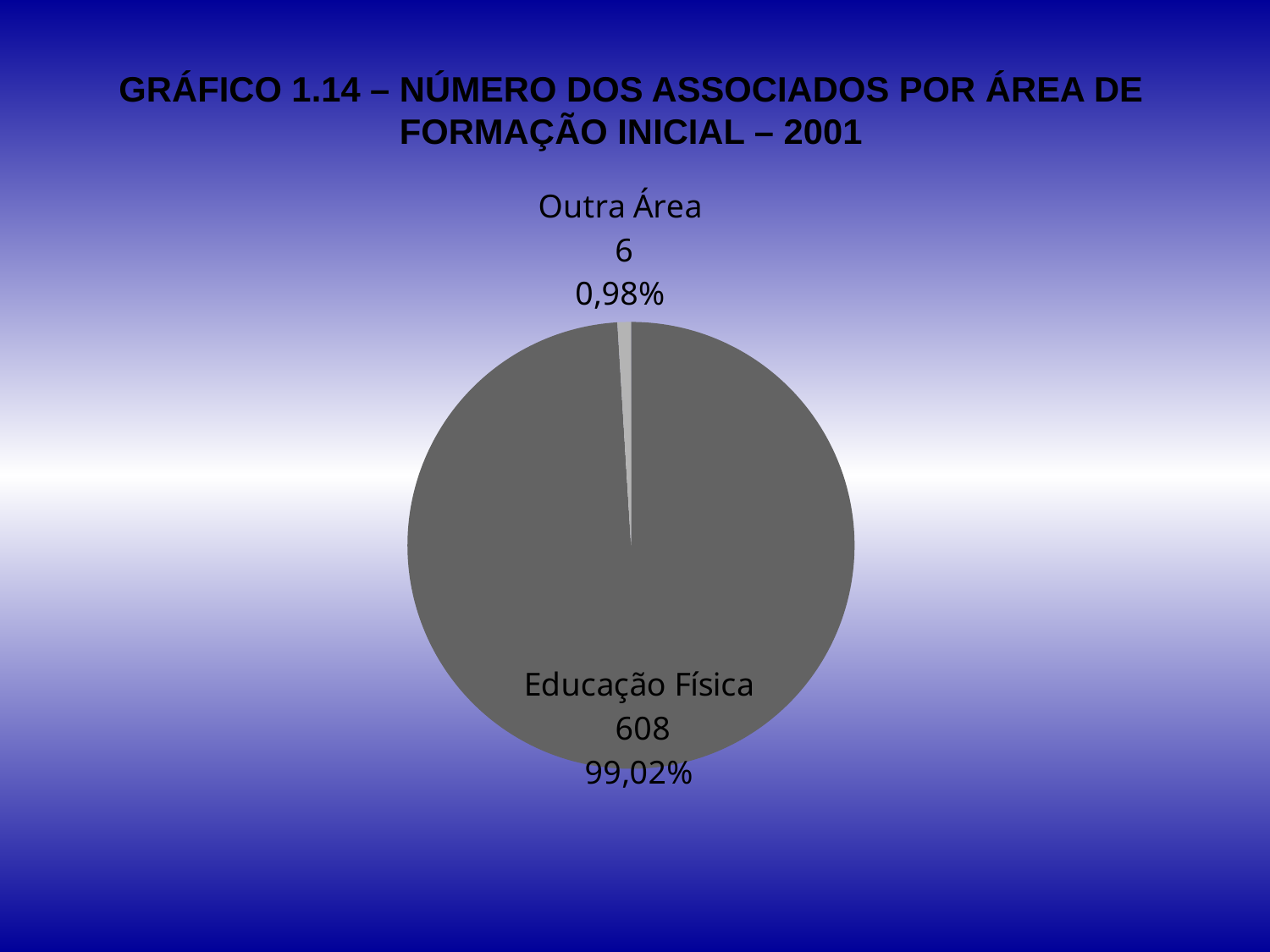
Which category has the smallest slice? Outra Área How many slices does the pie chart have? 2 Which is larger, the value for Educação Física or the value for Outra Área? Educação Física Which category has the largest slice? Educação Física What kind of chart is shown on the slide? pie chart What share of the pie does Educação Física represent? 99,02% What is the total number of associates across both slices? 614 What share of the pie does Outra Área represent? 0,98% What is the number of associates for Outra Área? 6 What is the number of associates for Educação Física? 608 What year does the chart title refer to? 2001 What is the difference between the number of associates in Educação Física and Outra Área? 602